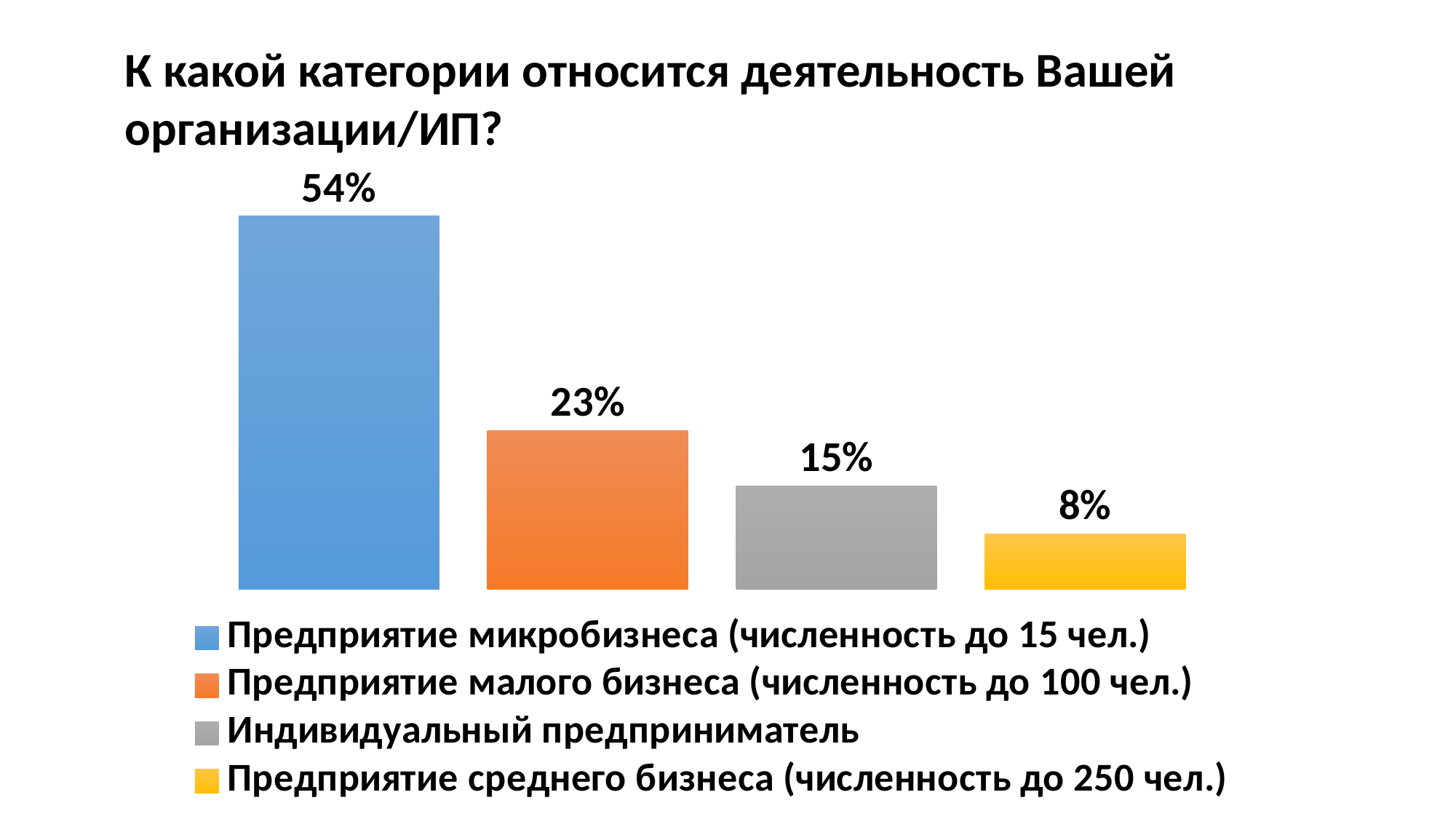
Which category has the highest value? Предприятие микробизнеса (численность до 15 чел.) What colour is the bar for Индивидуальный предприниматель? Grey How many categories are shown in the chart? 4 Which is larger: the value for Предприятие малого бизнеса or the value for Индивидуальный предприниматель? Предприятие малого бизнеса What is the difference between the values for Предприятие микробизнеса and Предприятие малого бизнеса? 31% Which category has the lowest value? Предприятие среднего бизнеса (численность до 250 чел.) What is the value for Предприятие микробизнеса (численность до 15 чел.)? 54% What is the value for Индивидуальный предприниматель? 15% What kind of chart is shown on the slide? Bar chart What is the value for Предприятие малого бизнеса (численность до 100 чел.)? 23% What is the difference between the values for Индивидуальный предприниматель and Предприятие среднего бизнеса? 7% What is the value for Предприятие среднего бизнеса (численность до 250 чел.)? 8%